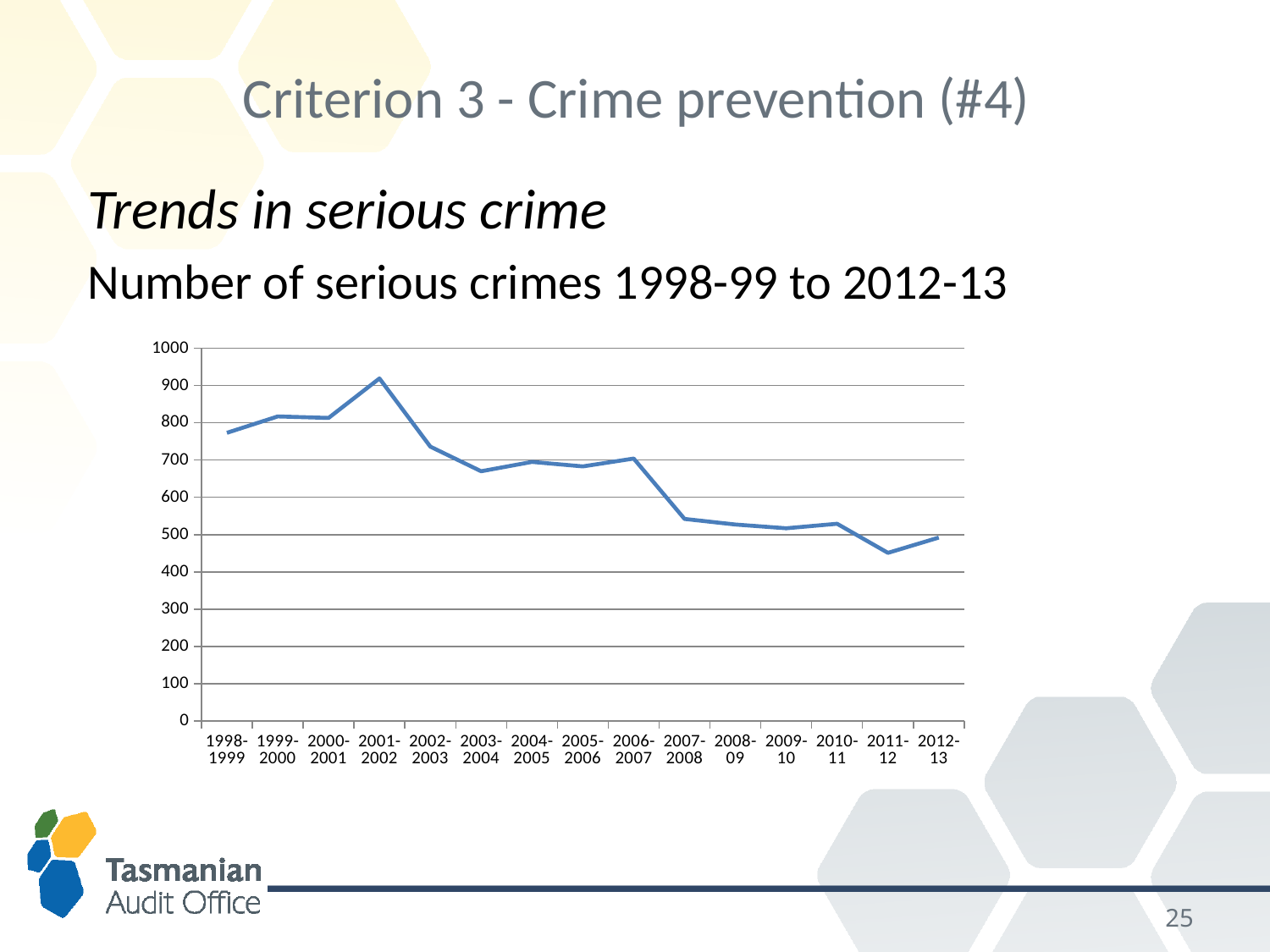
Which year has the lowest number of serious crimes? 2011-12 Is the value for 1998-1999 greater or less than 700? greater Which is larger, the value for 1998-1999 or the value for 2012-13? 1998-1999 How many financial years are plotted along the x axis? 15 Which is larger, the value for 2006-2007 or the value for 2007-2008? 2006-2007 Which year has the highest number of serious crimes? 2001-2002 Is the value for 2001-2002 greater or less than 900? greater Is the value for 2007-2008 greater or less than 600? less Overall, do the number of serious crimes rise or fall from 1998-1999 to 2012-13? fall What is the highest value shown on the y axis? 1000 What kind of chart is shown on the slide? line chart